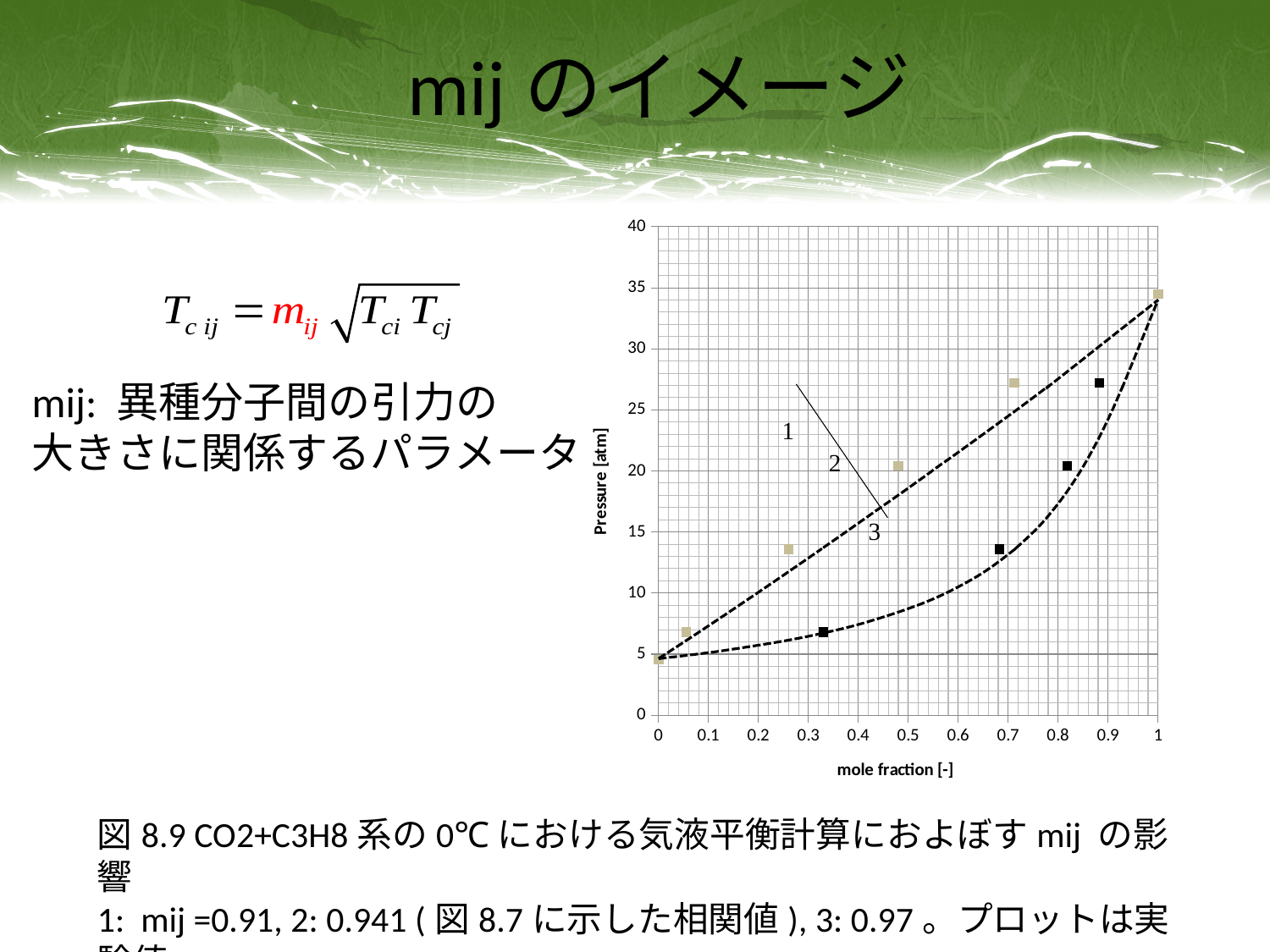
Is the pressure of the light-coloured point near mole fraction 0.5 greater or less than 15 atm? greater What is the title of the vertical axis of the chart? Pressure [atm] What is the title of the horizontal axis of the chart? mole fraction [-] What kind of chart is shown on the slide? scatter chart Is the pressure of the light-coloured point near mole fraction 0.7 greater or less than 25 atm? greater Is the pressure of the plotted point at mole fraction 1 greater or less than 30 atm? greater What is the maximum value shown on the vertical axis of the chart? 40 Do the plotted pressure values rise or fall as the mole fraction increases from 0 to 1? rise At mole fraction around 0.7, which point has the higher pressure: the light-coloured point or the black point? the light-coloured point